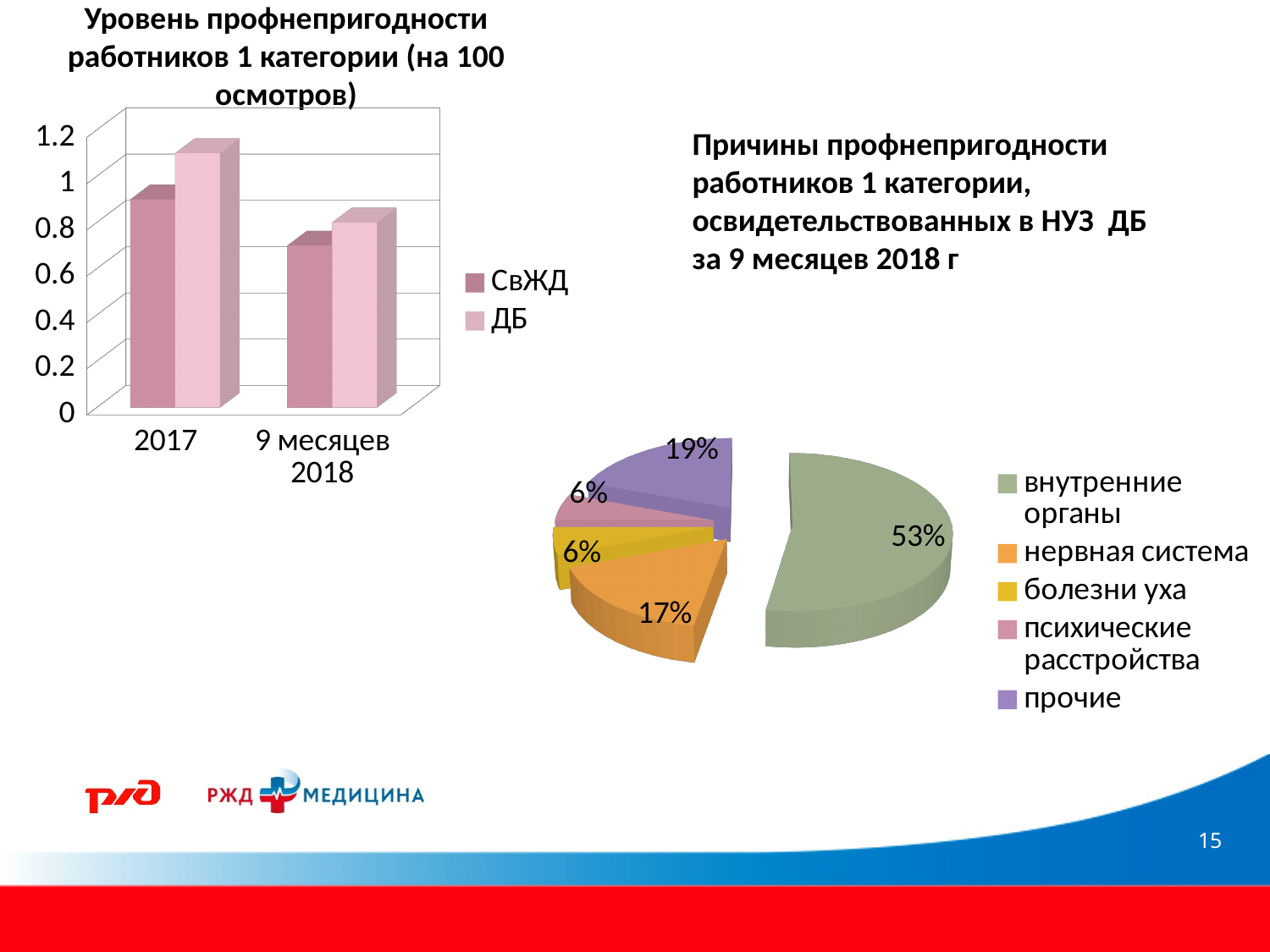
In the left bar chart, do the values for ДБ rise or fall from 2017 to 9 месяцев 2018? fall In the right pie chart, which category has the largest share? внутренние органы In the left bar chart, which series has the larger value in 2017, СвЖД or ДБ? ДБ In the left bar chart, is the value for СвЖД in 2017 greater or less than 1? less In the left bar chart, is the value for ДБ in 2017 greater or less than 1? greater In the left bar chart, is the value for СвЖД in 9 месяцев 2018 greater or less than 0.8? less In the right pie chart 'Причины профнепригодности работников 1 категории', what share is внутренние органы? 53% In the left chart 'Уровень профнепригодности работников 1 категории (на 100 осмотров)', what kind of chart is it? bar chart In the right pie chart, what share is нервная система? 17% In the right pie chart, how many categories does the legend list? 5 In the left bar chart, how many categories are shown on the x axis? 2 In the left bar chart, how many series does the legend list? 2